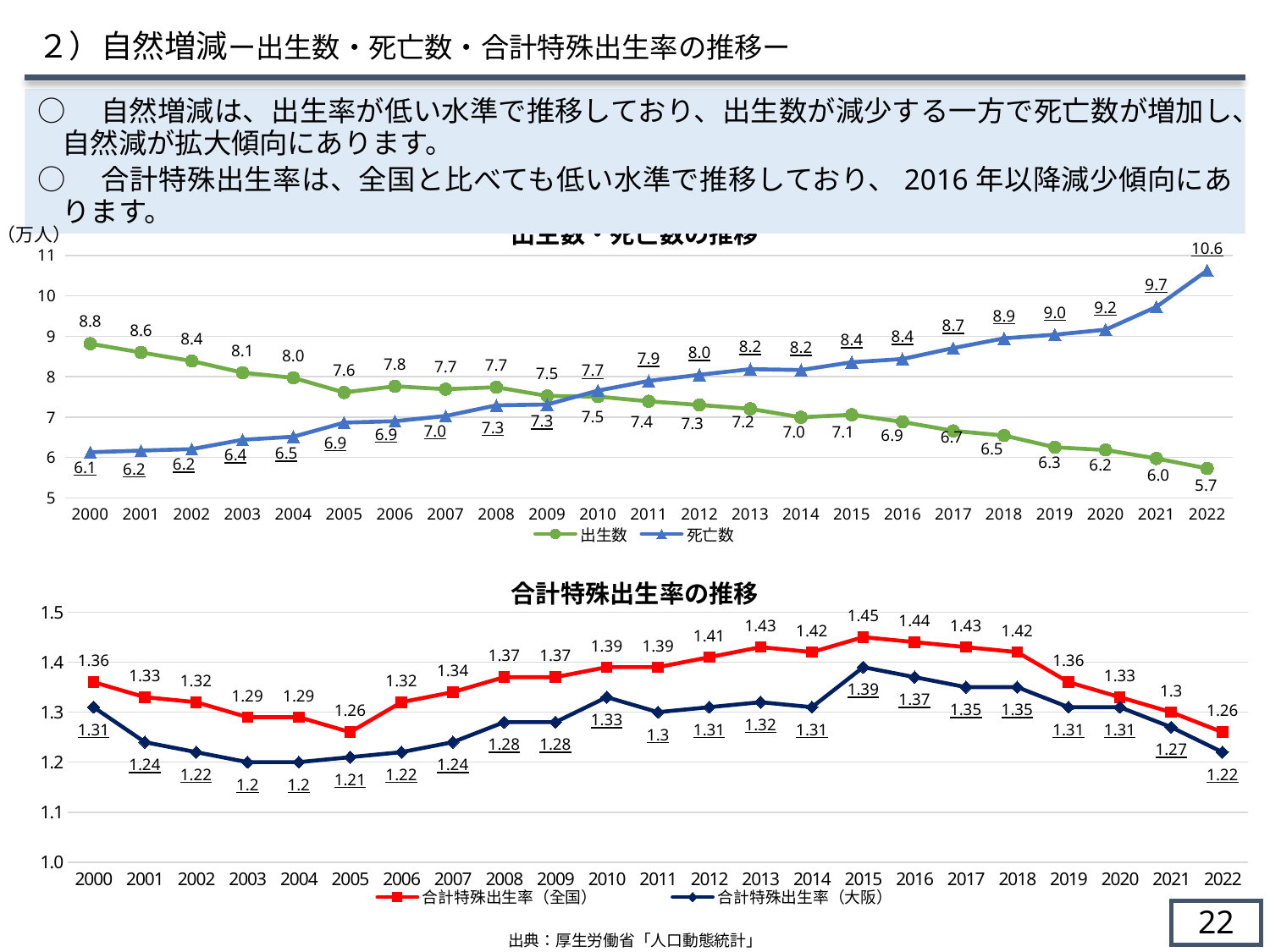
In the chart titled 合計特殊出生率の推移, what is the value of 合計特殊出生率（大阪） in 2015? 1.39 What type of chart is the bottom chart titled 合計特殊出生率の推移? line chart In the chart titled 合計特殊出生率の推移, what is the difference between 合計特殊出生率（全国） and 合計特殊出生率（大阪） in 2000? 0.05 In the top chart (出生数・死亡数の推移), what is the value of 出生数 in 2000? 8.8 In the top chart (出生数・死亡数の推移), which year has the lowest 出生数 value? 2022 In the chart titled 合計特殊出生率の推移, how many years are shown on the x axis? 23 In the top chart (出生数・死亡数の推移), how many series does the legend list? 2 In the top chart (出生数・死亡数の推移), what is the difference between 死亡数 and 出生数 in 2022? 4.9 In the top chart (出生数・死亡数の推移), which is larger in 2005, 出生数 or 死亡数? 出生数 In the chart titled 合計特殊出生率の推移, which year has the highest 合計特殊出生率（全国） value? 2015 In the top chart (出生数・死亡数の推移), does 死亡数 rise or fall from 2000 to 2022? rise In the top chart (出生数・死亡数の推移), what is the value of 死亡数 in 2022? 10.6